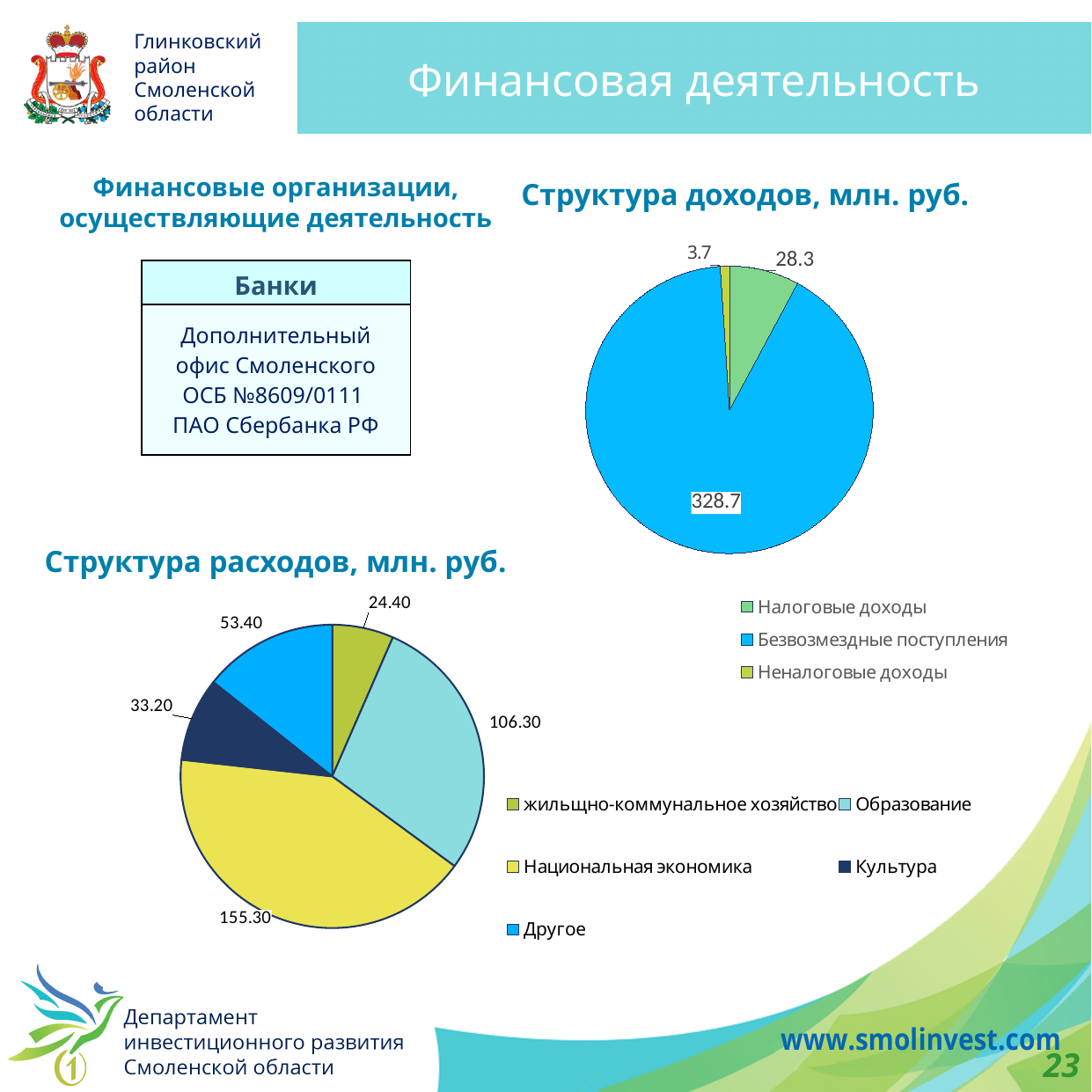
In the chart 'Структура расходов, млн. руб.', which category has the largest value? Национальная экономика In the chart 'Структура расходов, млн. руб.', how many categories are shown? 5 In the chart 'Структура доходов, млн. руб.', what is the value for Налоговые доходы? 28.3 In the chart 'Структура расходов, млн. руб.', which is larger: Культура or Другое? Другое In the chart 'Структура расходов, млн. руб.', what is the difference between Национальная экономика and Образование? 49.00 In the chart 'Структура доходов, млн. руб.', what is the difference between Налоговые доходы and Неналоговые доходы? 24.6 In the chart 'Структура расходов, млн. руб.', which category has the smallest value? жильщно-коммунальное хозяйство In the chart 'Структура доходов, млн. руб.', which category has the smallest value? Неналоговые доходы What type of chart is 'Структура расходов, млн. руб.'? Pie chart In the chart 'Структура доходов, млн. руб.', what is the value for Безвозмездные поступления? 328.7 In the chart 'Структура доходов, млн. руб.', how many categories does the legend list? 3 In the chart 'Структура расходов, млн. руб.', what is the value for Образование? 106.30